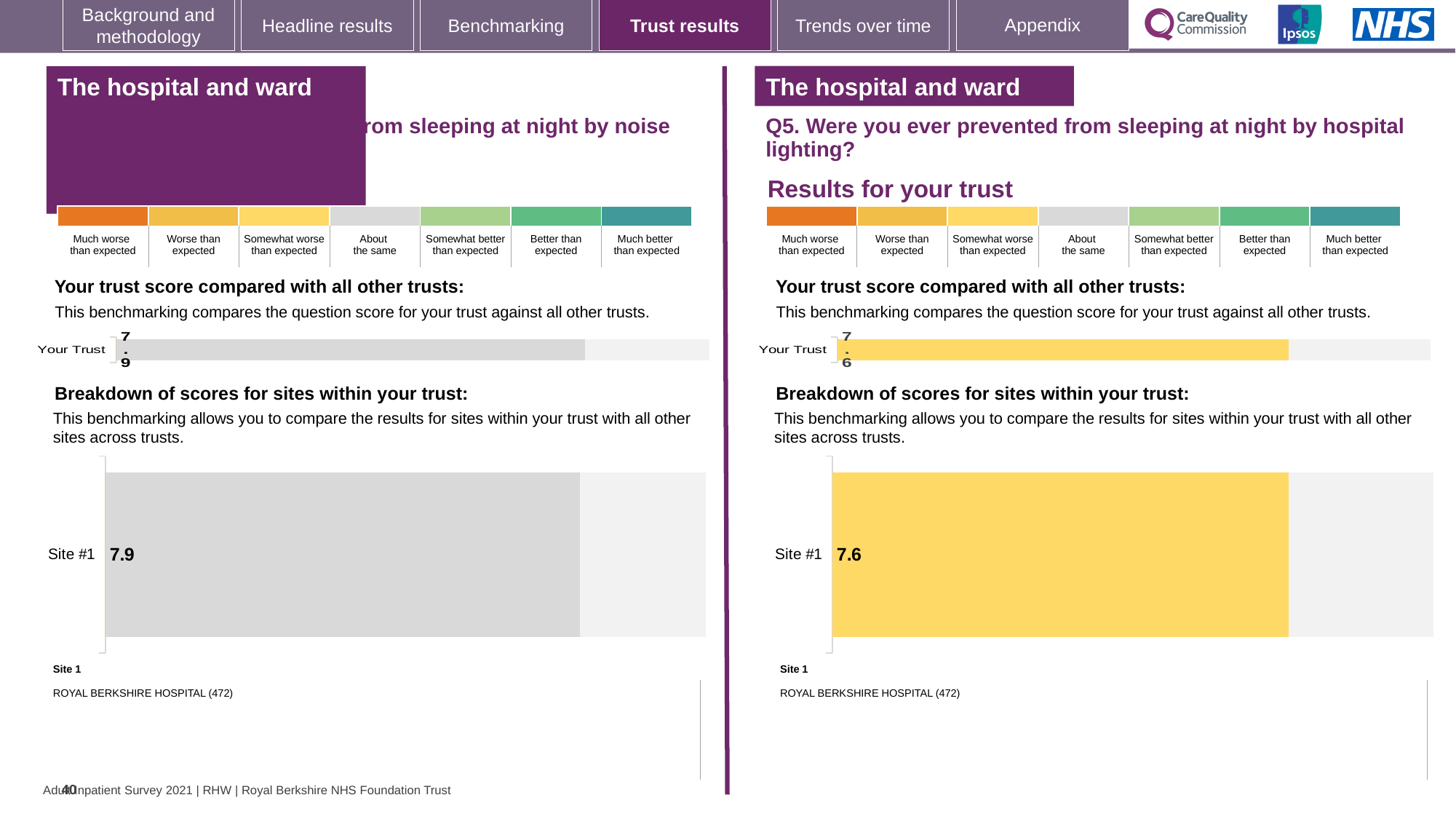
On the left-hand 'Your trust score compared with all other trusts' chart (sleeping at night by noise), what is the value for Your Trust? 7.9 How many sites are shown on the left-hand 'Breakdown of scores for sites within your trust' chart? 1 On the left-hand 'Breakdown of scores for sites within your trust' chart (sleeping at night by noise), what is the value for Site #1? 7.9 According to the colour key, what does the grey colour of the Site #1 bar on the left-hand breakdown chart (noise) indicate? About the same On the right-hand 'Breakdown of scores for sites within your trust' chart (Q5, hospital lighting), what is the value for Site #1? 7.6 What is the difference between the Your Trust score on the left-hand chart (noise) and the Your Trust score on the right-hand chart (hospital lighting)? 0.3 What kind of chart is used for the 'Breakdown of scores for sites within your trust' on the right-hand side? Bar chart How many sites are shown on the right-hand 'Breakdown of scores for sites within your trust' chart? 1 According to the colour key, what does the yellow colour of the Site #1 bar on the right-hand breakdown chart (Q5, hospital lighting) indicate? Somewhat worse than expected On the right-hand 'Your trust score compared with all other trusts' chart (Q5, hospital lighting), what is the value for Your Trust? 7.6 Which is larger: the Site #1 score on the left-hand breakdown chart (noise) or the Site #1 score on the right-hand breakdown chart (hospital lighting)? Left-hand (noise), 7.9 Which site name is listed as Site 1 beneath the right-hand breakdown chart? ROYAL BERKSHIRE HOSPITAL (472)